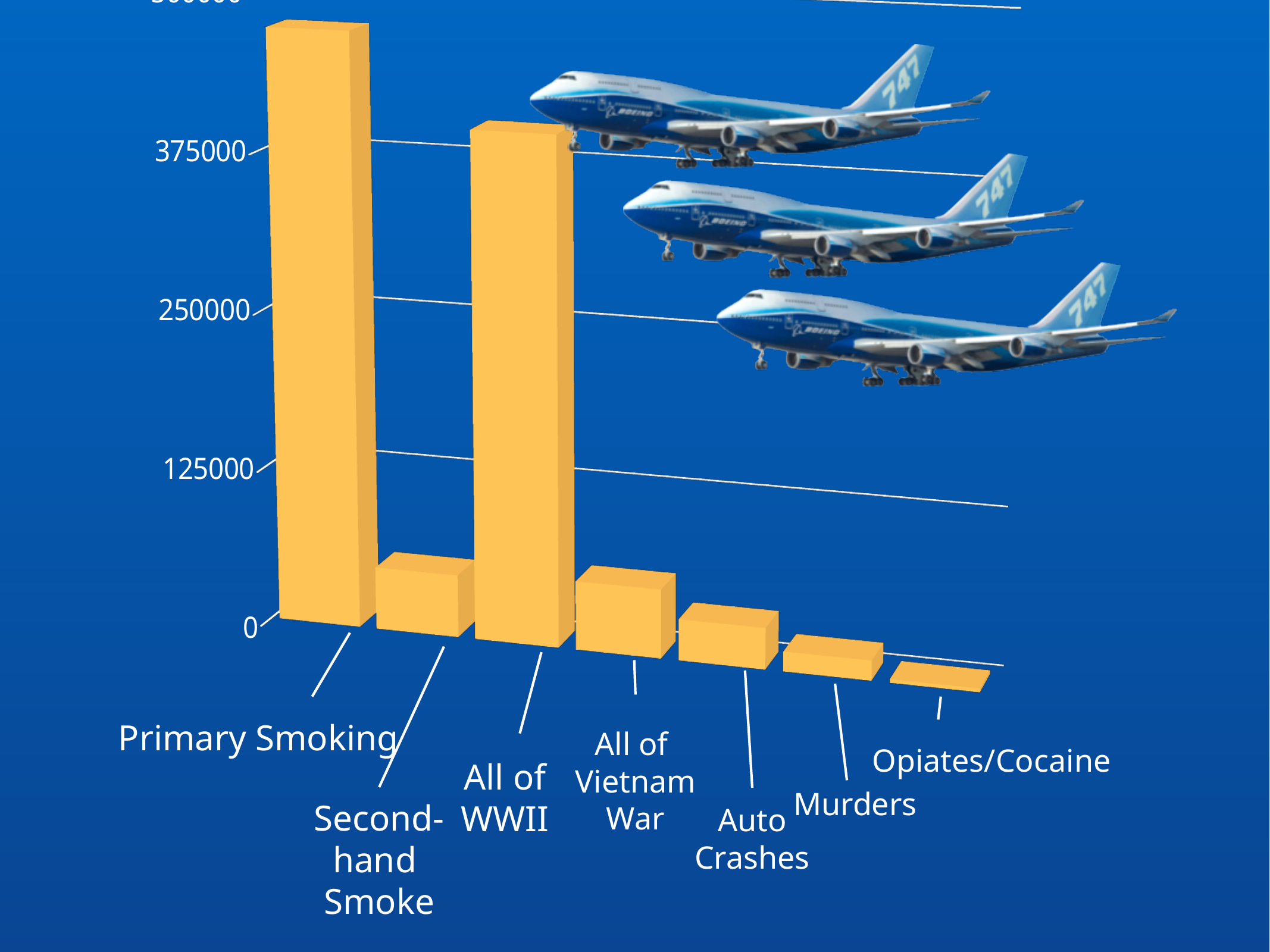
Is the value for Auto Crashes greater or less than 125000? less Which category has the highest value on the chart? Primary Smoking Which is larger, the value for All of WWII or the value for All of Vietnam War? All of WWII Which is larger, the value for Murders or the value for Opiates/Cocaine? Murders Is the value for Second-hand Smoke greater or less than 125000? less What colour are the bars on the chart? orange Which is larger, the value for Primary Smoking or the value for All of WWII? Primary Smoking What kind of chart is shown on the slide? bar chart Which category has the lowest value on the chart? Opiates/Cocaine Is the value for All of WWII greater or less than 250000? greater How many categories are plotted on the chart? 7